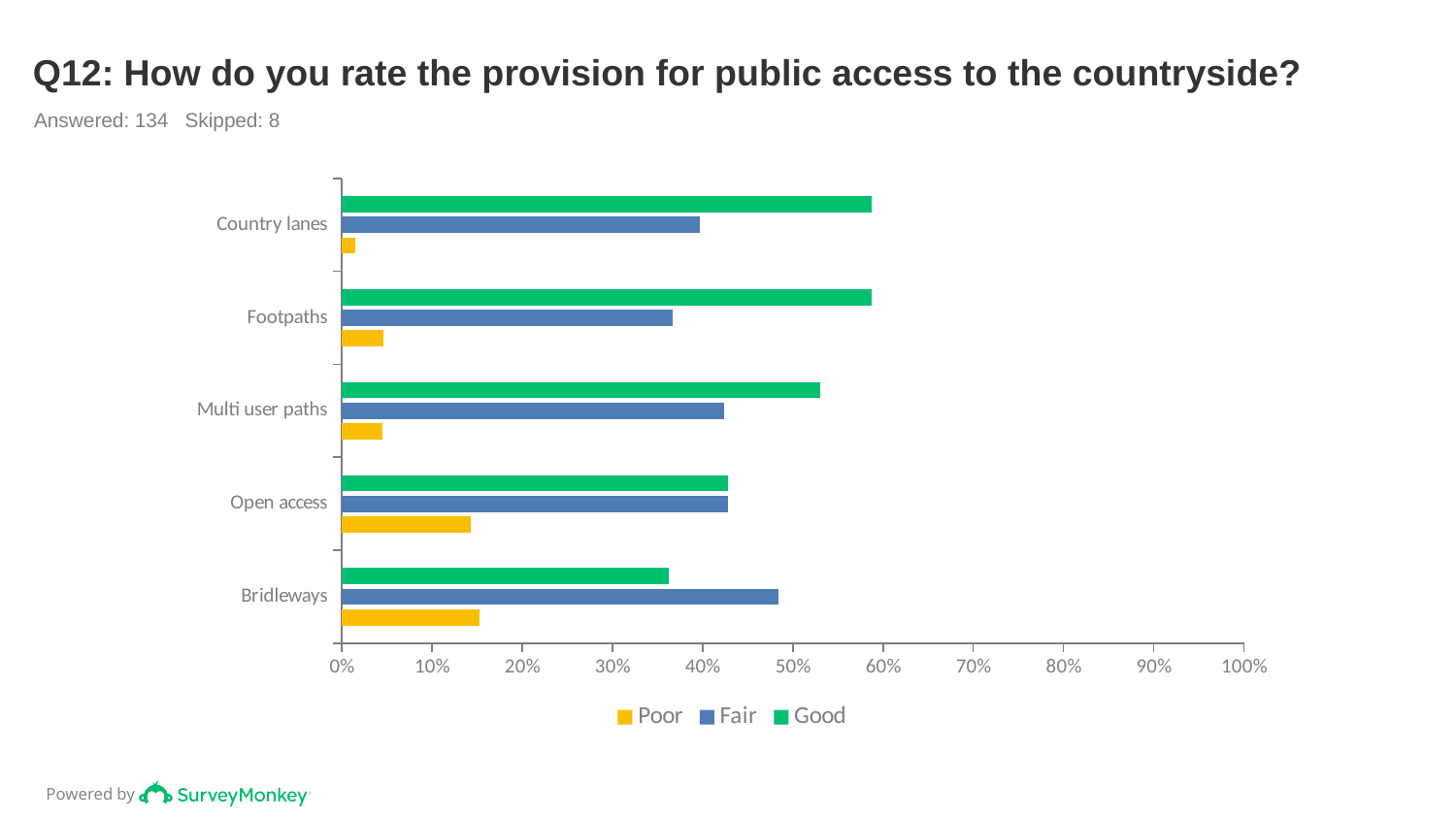
What colour represents the Good series in the legend? green How many categories are shown on the chart? 5 Is the Good value for Country lanes greater or less than 50%? greater Which category has the lowest Good value? Bridleways Is the Poor value for Open access greater or less than 10%? greater How many series does the legend list? 3 Which category has the lowest Poor value? Country lanes Which category has the highest Fair value? Bridleways For Bridleways, which is larger: the Fair value or the Good value? Fair For Multi user paths, which is larger: the Good value or the Fair value? Good What kind of chart is shown on the slide? bar chart Is the Fair value for Footpaths greater or less than 40%? less